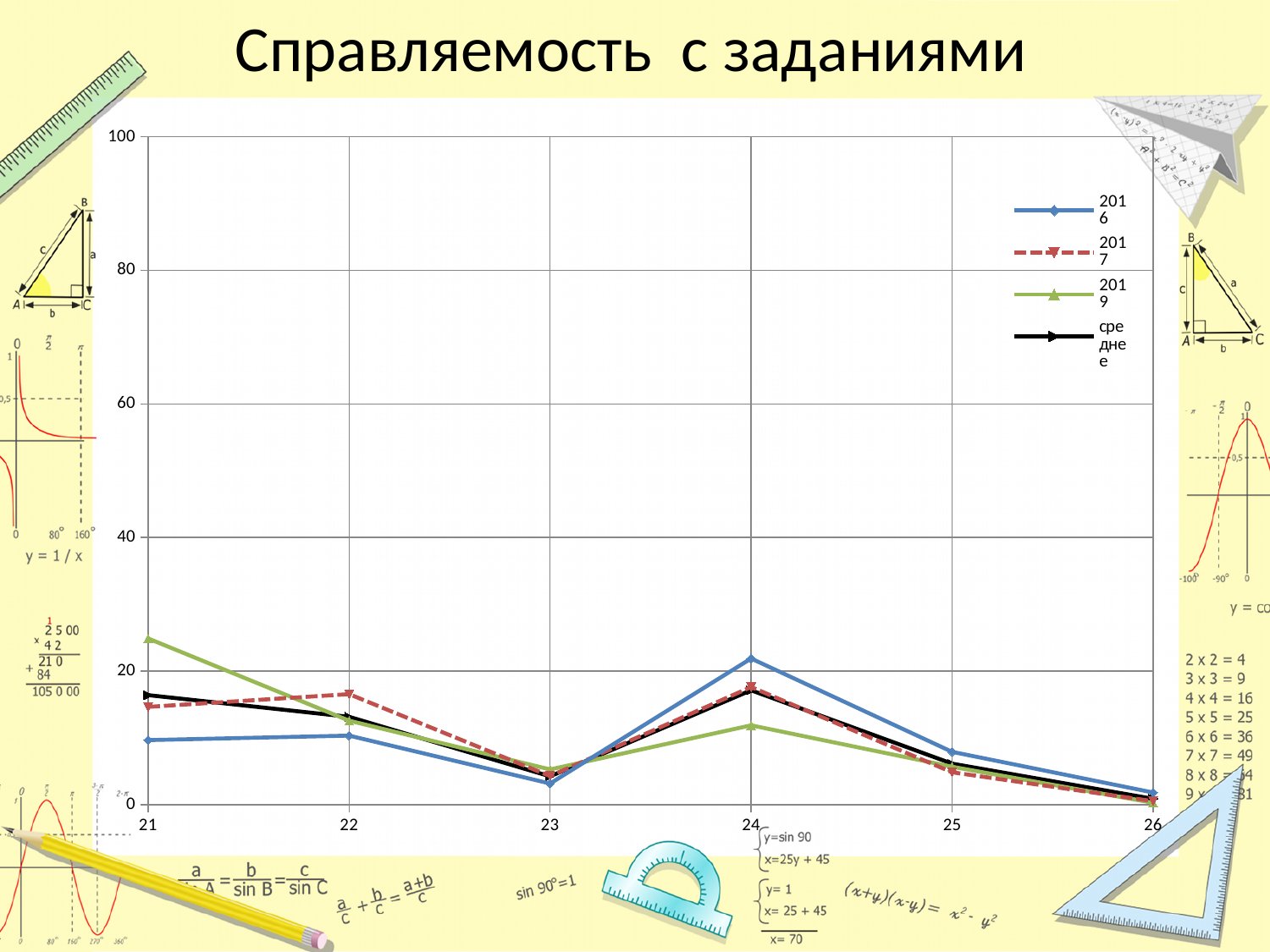
How many series does the legend list? 4 Is the value for 2019 at category 21 greater or less than 20? greater Is the value for среднее at category 23 greater or less than 20? less How many categories are shown on the x axis? 6 Which category has the highest value for the 2019 series? 21 Which category has the highest value for the 2016 series? 24 What kind of chart is shown on the slide? line chart Is the value for 2016 at category 21 greater or less than 20? less Do the values for the 2016 series rise or fall from category 24 to category 26? fall At category 24, which series has the larger value, 2016 or 2019? 2016 What is the title of the slide? Справляемость с заданиями At category 21, which series has the larger value, 2016 or 2019? 2019